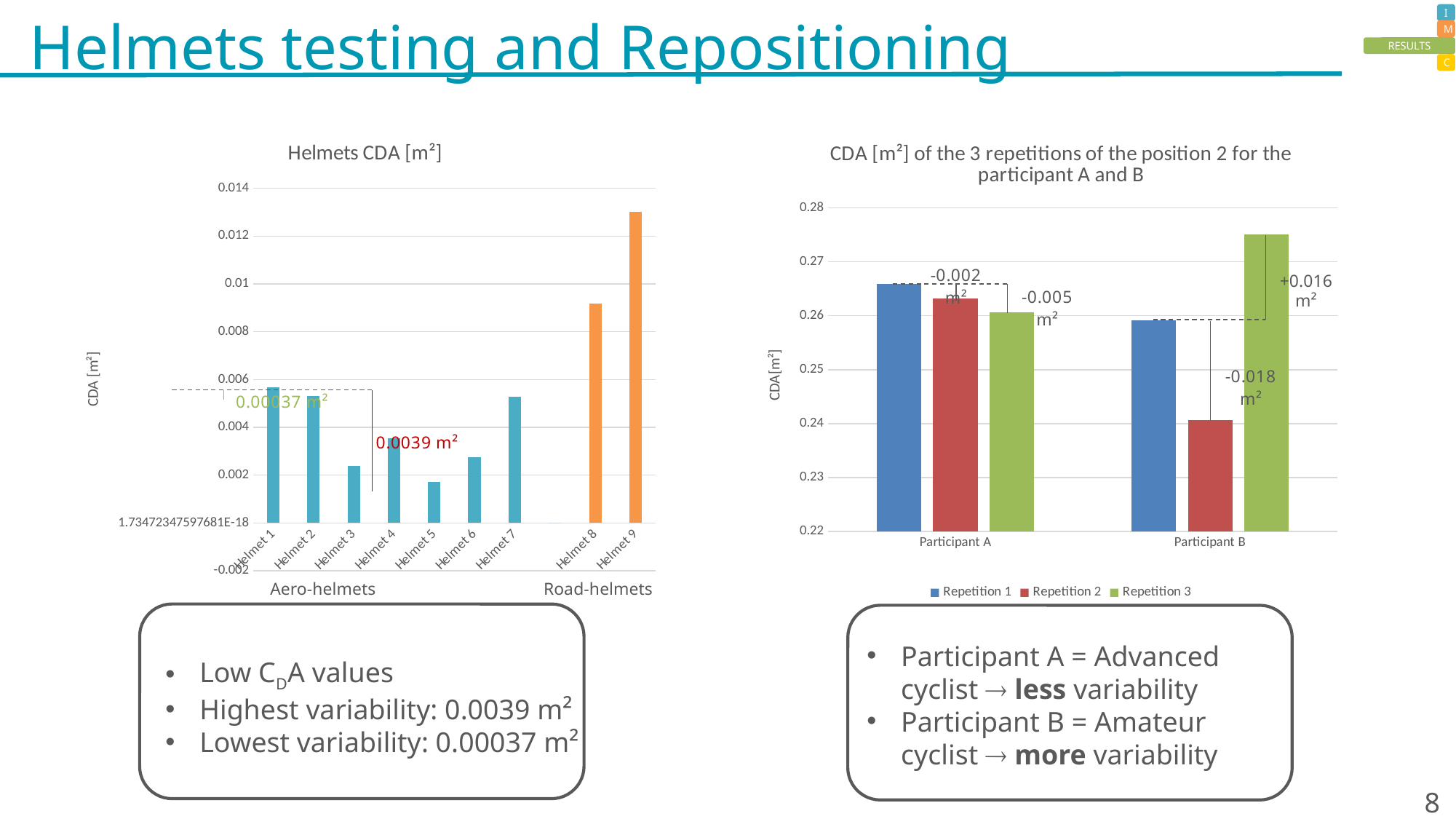
What kind of chart is the 'Helmets CDA [m²]' chart on the left? Bar chart In the 'Helmets CDA [m²]' chart, which helmet has the lowest CDA value? Helmet 5 In the 'Helmets CDA [m²]' chart, is the value for Helmet 9 greater or less than 0.012? greater In the 'Helmets CDA [m²]' chart, is the value for Helmet 8 greater or less than 0.01? less In the chart on the right, how many series does the legend list? 3 In the chart on the right, which bar is the lowest? Repetition 2 for Participant B In the chart on the right, what difference is annotated between Repetition 1 and Repetition 3 for Participant B? +0.016 m² In the 'Helmets CDA [m²]' chart, how many helmets are plotted? 9 In the 'Helmets CDA [m²]' chart, which helmet has the highest CDA value? Helmet 9 In the chart on the right, which bar is the highest? Repetition 3 for Participant B In the chart on the right, is the Repetition 2 value for Participant B greater or less than 0.25? less In the 'Helmets CDA [m²]' chart, which two groups are the helmets divided into? Aero-helmets and Road-helmets